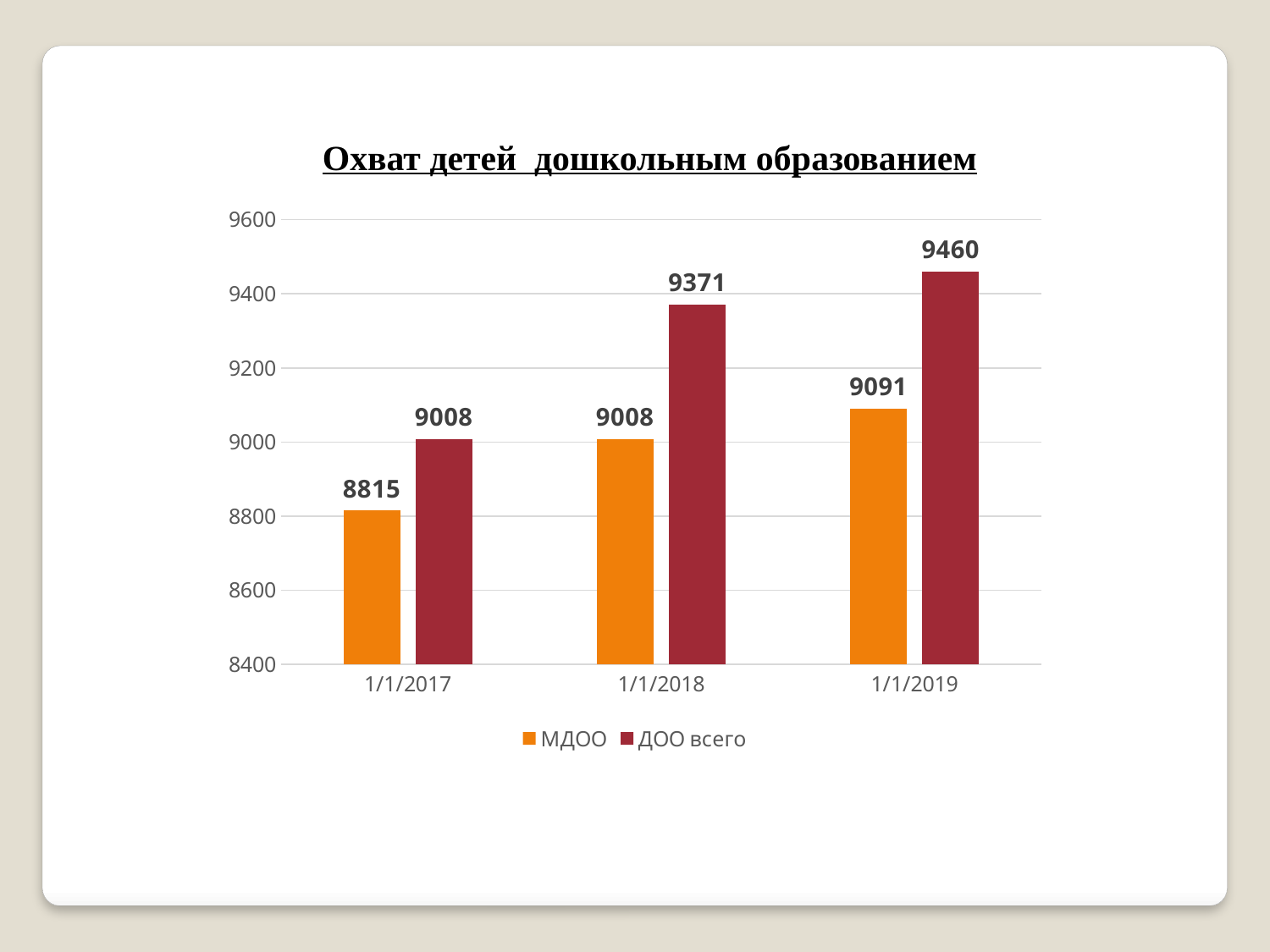
Which is larger on 1/1/2018: МДОО or ДОО всего? ДОО всего What is the value for МДОО on 1/1/2017? 8815 On which date is the ДОО всего value highest? 1/1/2019 How many dates are shown on the x axis? 3 What is the difference between ДОО всего and МДОО on 1/1/2019? 369 What is the value for МДОО on 1/1/2019? 9091 On which date is the МДОО value lowest? 1/1/2017 What is the difference between the ДОО всего values on 1/1/2018 and 1/1/2017? 363 What is the value for ДОО всего on 1/1/2019? 9460 How many series does the legend list? 2 Do the ДОО всего values rise or fall from 1/1/2017 to 1/1/2019? rise What is the value for ДОО всего on 1/1/2018? 9371